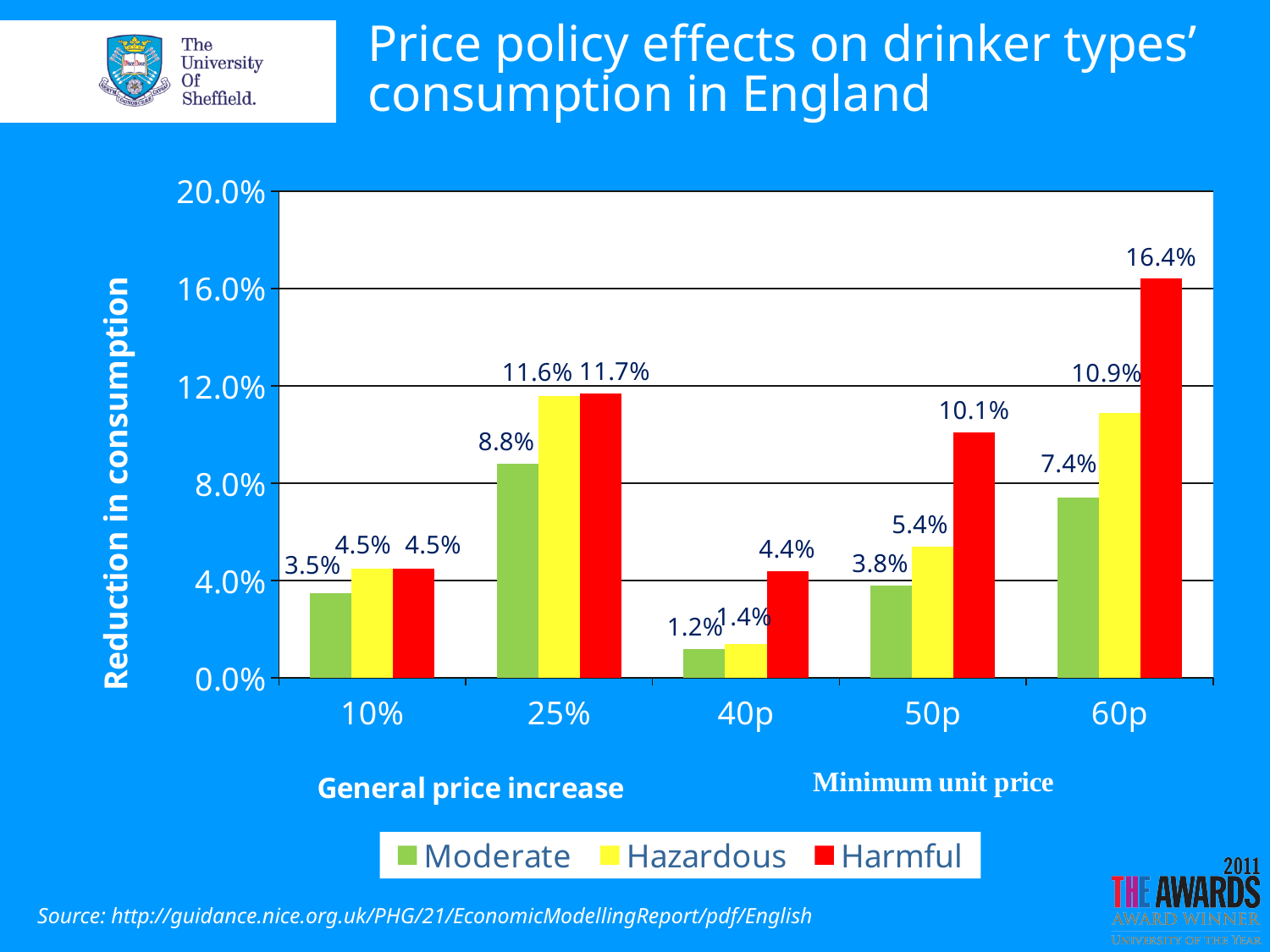
How many price policy categories are shown on the x axis? 5 Which price policy gives the smallest reduction in consumption for Moderate drinkers? 40p What is the reduction in consumption for Hazardous drinkers at a 50p minimum unit price? 5.4% What is the difference between the Harmful and Hazardous reductions at a 40p minimum unit price? 3.0% Which colour represents Harmful drinkers in the chart? Red What is the reduction in consumption for Moderate drinkers under a 25% general price increase? 8.8% What is the difference between the Harmful and Moderate reductions at a 60p minimum unit price? 9.0% Which price policy gives the largest reduction in consumption for Harmful drinkers? 60p How many drinker types does the legend list? 3 What is the reduction in consumption for Harmful drinkers at a 60p minimum unit price? 16.4% What kind of chart is shown on the slide? Bar chart Which is larger: the Hazardous reduction at 60p or the Harmful reduction at 50p? Hazardous at 60p